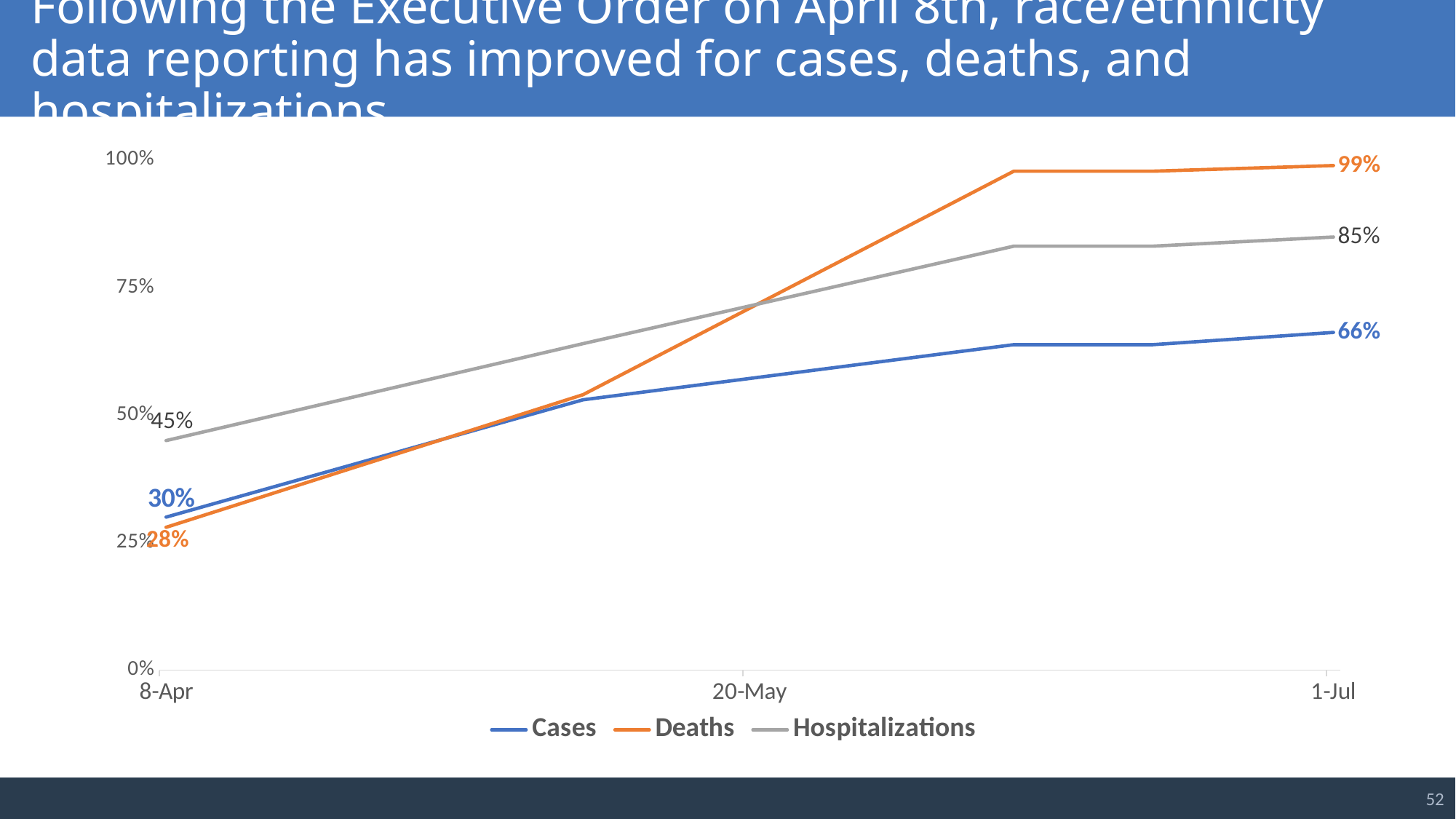
Do the values for Cases rise or fall from 8-Apr to 1-Jul? rise What is the value for Cases on 8-Apr? 30% What is the value for Hospitalizations on 8-Apr? 45% What is the value for Cases on 1-Jul? 66% Which series has the lowest value on 8-Apr? Deaths What is the value for Deaths on 8-Apr? 28% What is the value for Deaths on 1-Jul? 99% What is the difference between the Deaths value on 1-Jul and on 8-Apr? 71% What type of chart is shown on the slide? line chart Which series has the highest value on 1-Jul? Deaths How many series does the legend list? 3 What is the value for Hospitalizations on 1-Jul? 85%